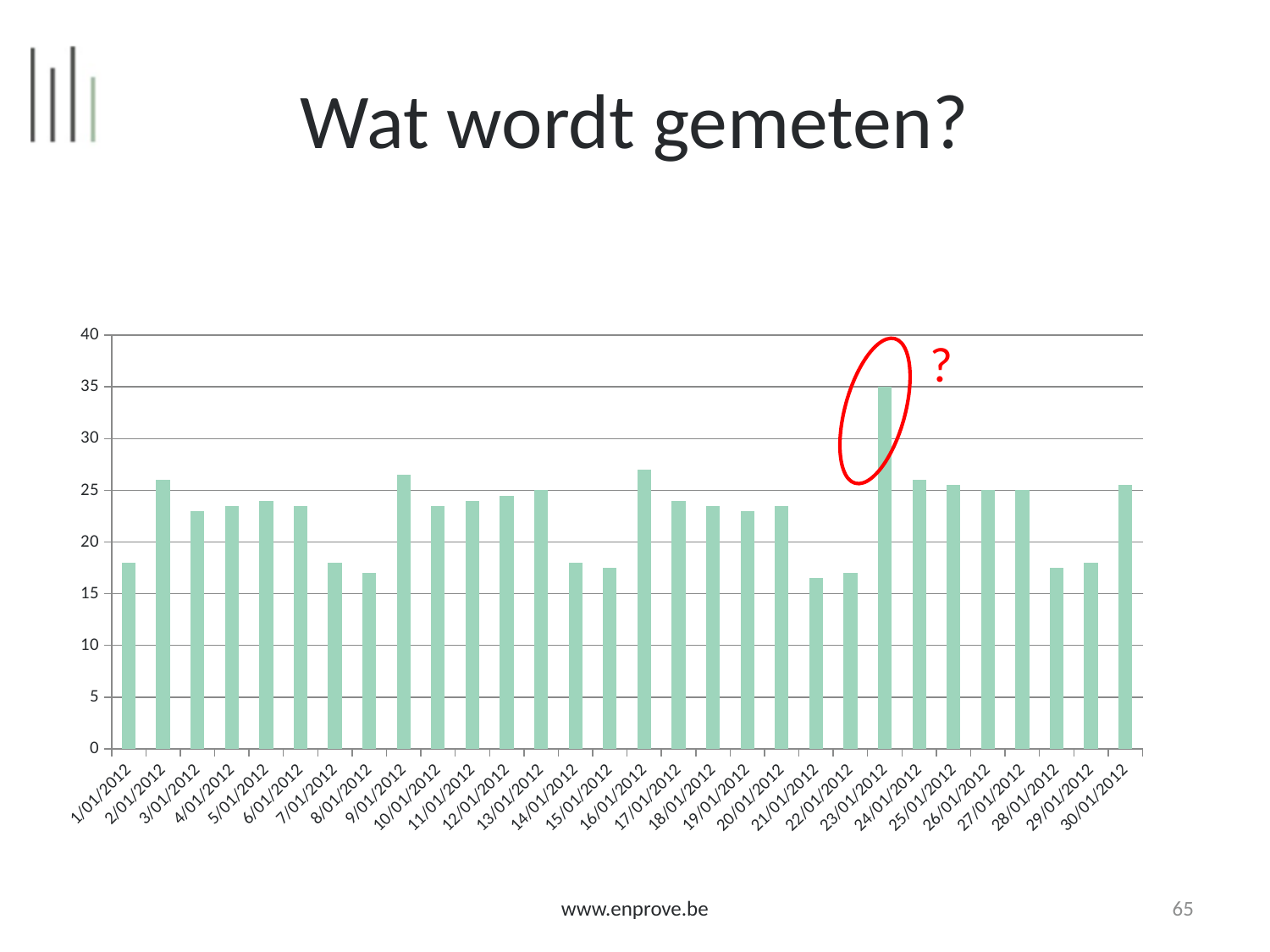
Is the value for 1/01/2012 greater or less than 20? less What kind of chart is shown on the slide? bar chart Is the value for 21/01/2012 greater or less than 20? less Which date has the highest bar on the chart? 23/01/2012 Which is larger, the value for 9/01/2012 or the value for 8/01/2012? 9/01/2012 How many dates (bars) are plotted on the chart? 30 Is the value for 23/01/2012 greater or less than 30? greater Which is larger, the value for 23/01/2012 or the value for 16/01/2012? 23/01/2012 What is the value for 23/01/2012? 35 Which bar on the chart is circled in red? 23/01/2012